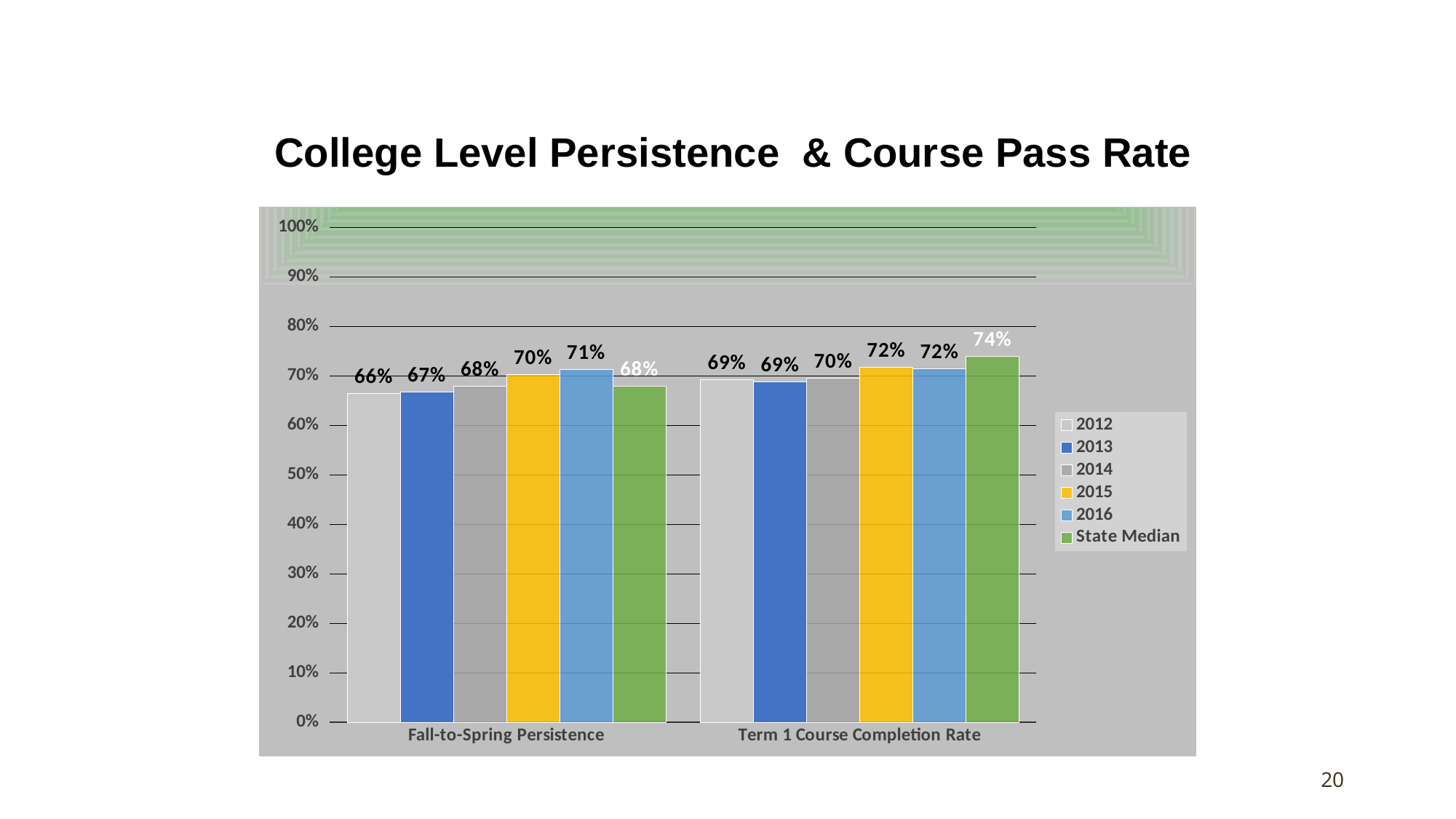
How many series does the legend list? 6 Which series has the lowest value for Fall-to-Spring Persistence? 2012 What is the 2016 value for Fall-to-Spring Persistence? 71% Which is larger for Term 1 Course Completion Rate: the 2015 value or the 2014 value? 2015 How many categories are shown on the x axis? 2 Do the values for Fall-to-Spring Persistence rise or fall from 2012 to 2016? Rise What is the difference between the 2016 and 2012 values for Fall-to-Spring Persistence? 5% What is the 2012 value for Term 1 Course Completion Rate? 69% What is the 2015 value for Fall-to-Spring Persistence? 70% Which series has the highest value for Term 1 Course Completion Rate? State Median What is the State Median value for Term 1 Course Completion Rate? 74% What kind of chart is shown on the slide? Bar chart